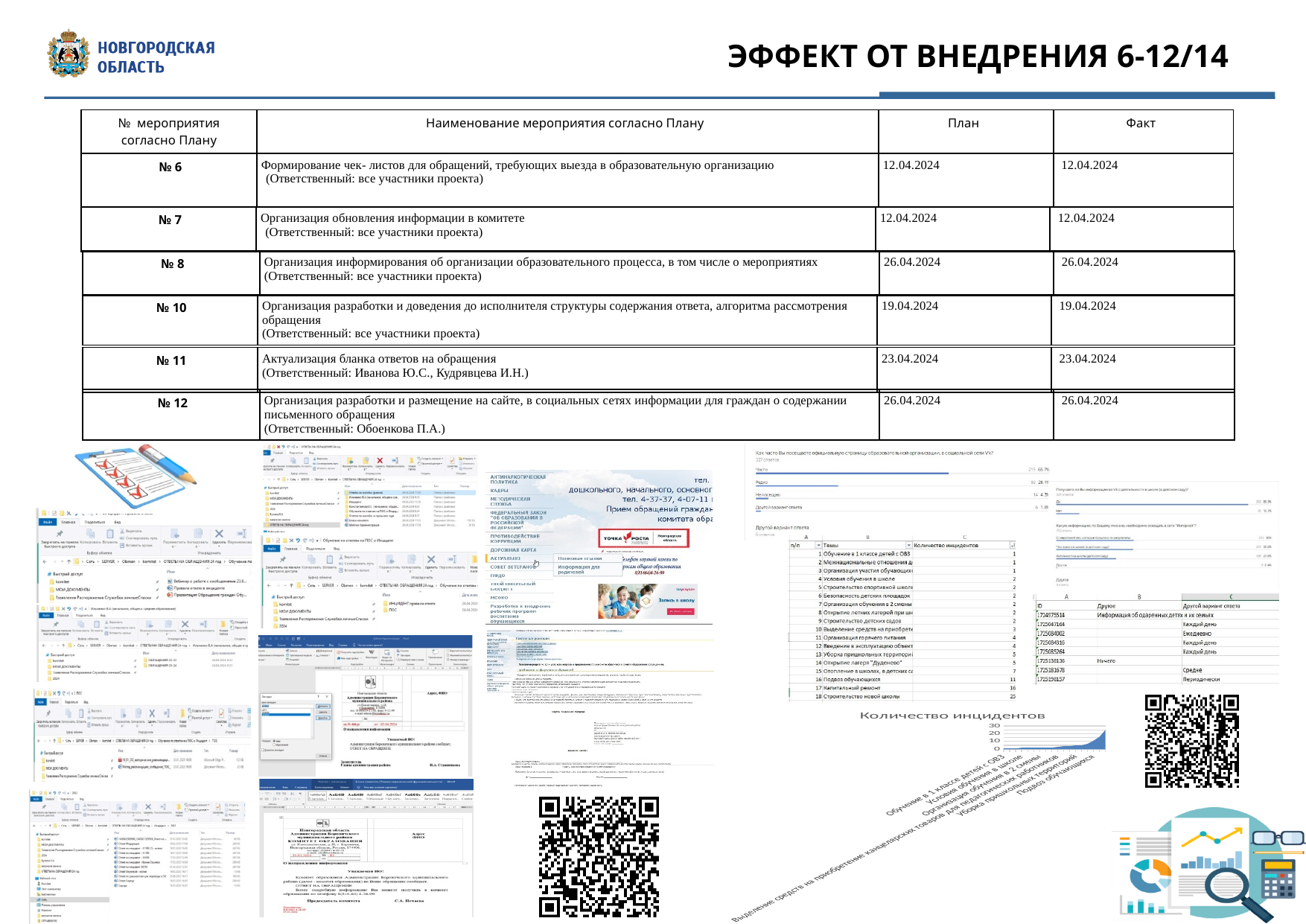
In the chart titled "Количество инцидентов", do the values generally rise or fall from left to right along the x axis? rise In the chart titled "Количество инцидентов", is the highest plotted value greater or less than 30? less What is the title of the chart at the bottom right of the slide? Количество инцидентов What is the highest tick value shown on the y axis of the chart titled "Количество инцидентов"? 30 In the chart titled "Количество инцидентов", is the highest plotted value greater or less than 10? greater